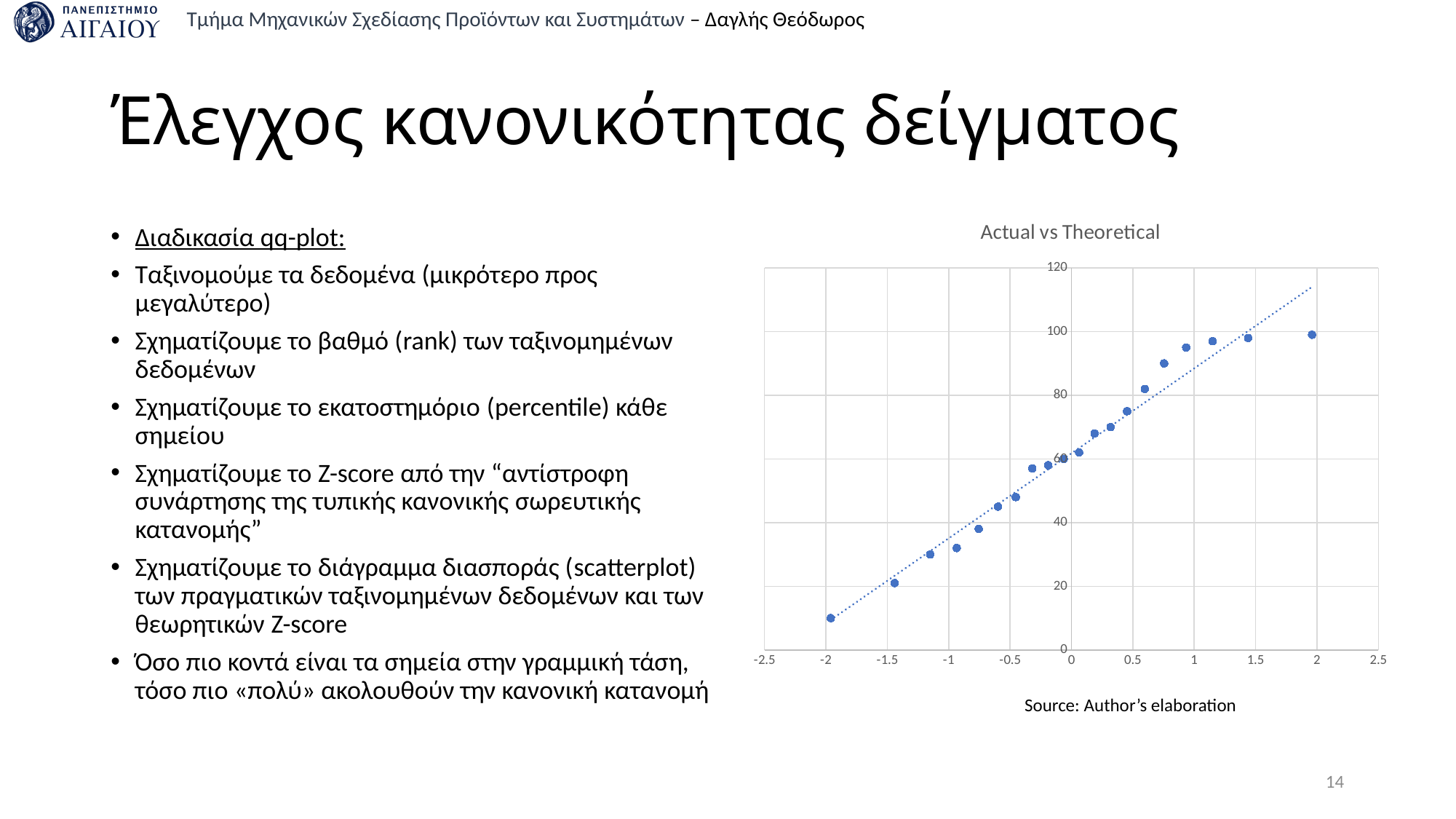
What is the highest value shown on the y-axis? 120 Is the y-value of the point at x ≈ -1 greater or less than 40? less Do the plotted values rise or fall as the x-axis value increases? rise Is the y-value of the leftmost point (at x ≈ -2) greater or less than 20? less Which has the larger y-value: the point at x ≈ 1 or the point at x ≈ -1? the point at x ≈ 1 Which point has the highest y-value: the one at x ≈ 2 or the one at x ≈ -2? the one at x ≈ 2 Is the y-value of the point at x ≈ 0.5 greater or less than 60? greater How many data points are plotted in the chart? 20 What is the title of the chart? Actual vs Theoretical What kind of chart is shown on the slide? scatter plot